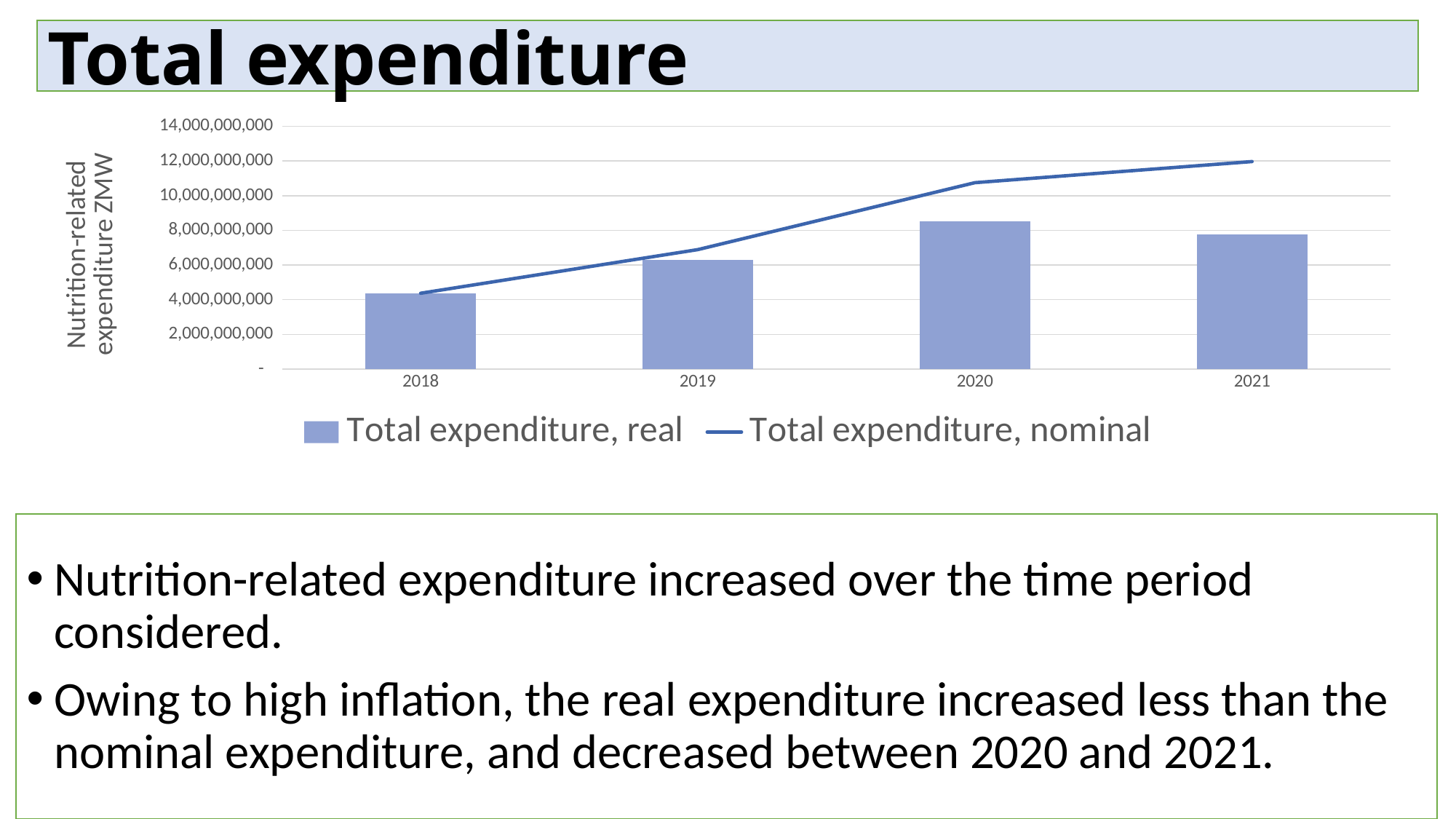
How many series does the chart legend list? 2 Does the Total expenditure, nominal line rise or fall from 2018 to 2021? Rises Is the Total expenditure, real value for 2020 greater or less than 8,000,000,000? greater Which series is drawn as a line in the chart? Total expenditure, nominal What kind of chart is shown on the slide? A combined bar and line chart How many years are shown on the x axis of the chart? 4 What is the label on the vertical axis of the chart? Nutrition-related expenditure ZMW Is the Total expenditure, real value for 2018 greater or less than 6,000,000,000? less Which is larger in 2021, Total expenditure, real or Total expenditure, nominal? Total expenditure, nominal Which year has the highest bar for Total expenditure, real? 2020 Is the Total expenditure, nominal value for 2020 greater or less than 10,000,000,000? greater Which year has the lowest bar for Total expenditure, real? 2018